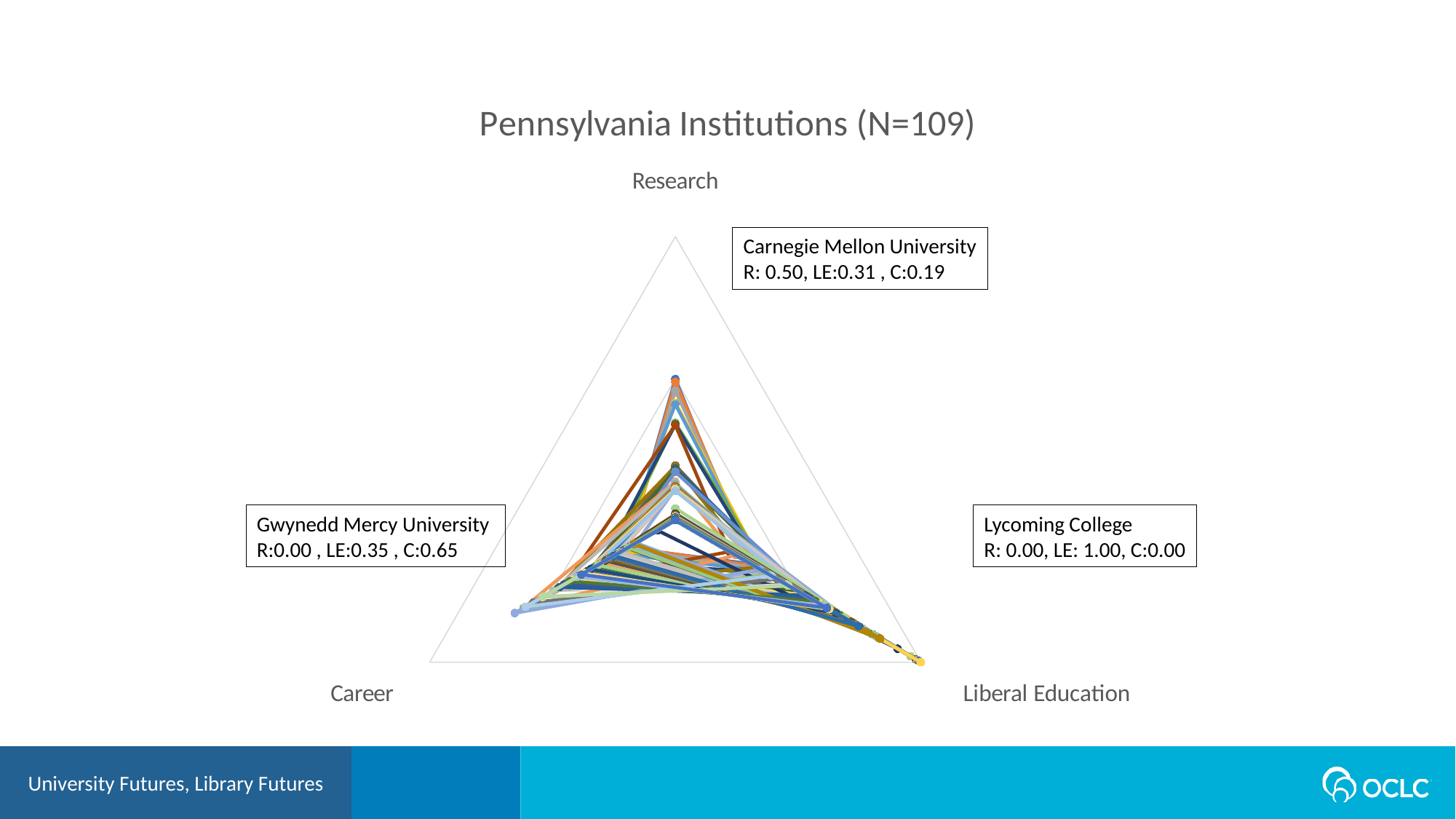
Which of the three annotated institutions has the highest Research (R) value? Carnegie Mellon University What is the title of the chart? Pennsylvania Institutions (N=109) What is the Liberal Education (LE) value given for Lycoming College? 1.00 How many axes (categories) does the radar chart have? 3 What is the difference between the Career (C) values of Gwynedd Mercy University and Carnegie Mellon University? 0.46 What is the Liberal Education (LE) value given for Carnegie Mellon University? 0.31 Which of the three annotated institutions has the highest Career (C) value? Gwynedd Mercy University What kind of chart is shown on the slide? Radar chart What is the Research (R) value given for Carnegie Mellon University? 0.50 What is the Career (C) value given for Gwynedd Mercy University? 0.65 Which is larger: the Liberal Education value for Gwynedd Mercy University or for Carnegie Mellon University? Gwynedd Mercy University What are the three axis labels on the radar chart? Research, Liberal Education, Career